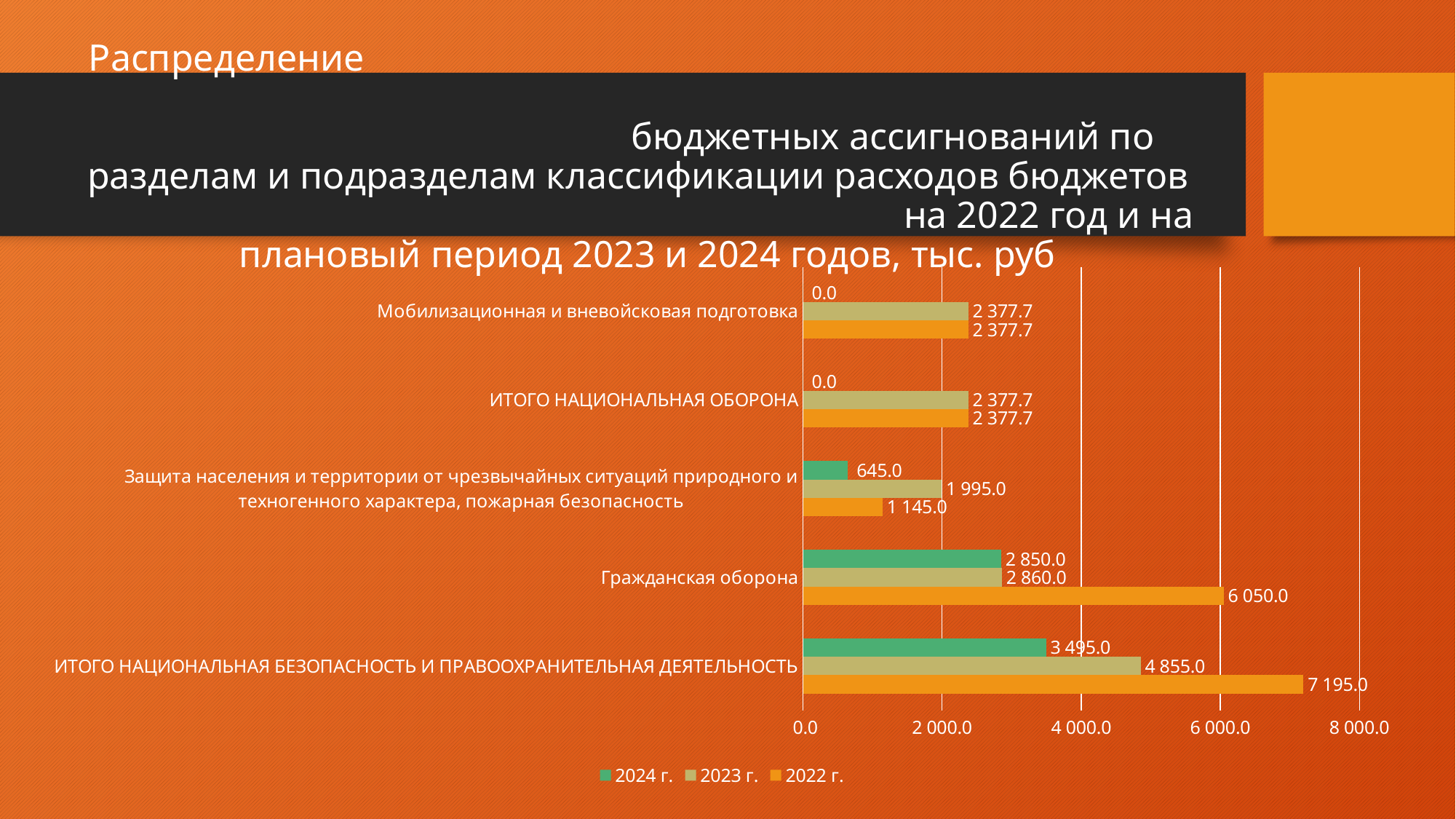
What is the value for 2024 г. for Защита населения и территории от чрезвычайных ситуаций природного и техногенного характера, пожарная безопасность? 645.0 What is the value for 2023 г. for Гражданская оборона? 2 860.0 Which category has the lowest value for 2023 г.? Защита населения и территории от чрезвычайных ситуаций природного и техногенного характера, пожарная безопасность How many series does the legend list? 3 How many categories are shown on the chart? 5 What is the difference between the 2022 г. and 2024 г. values for Гражданская оборона? 3 200.0 What is the value for 2024 г. for Мобилизационная и вневойсковая подготовка? 0.0 For Гражданская оборона, which is larger: the 2022 г. value or the 2023 г. value? 2022 г. Which category has the highest value for 2022 г.? ИТОГО НАЦИОНАЛЬНАЯ БЕЗОПАСНОСТЬ И ПРАВООХРАНИТЕЛЬНАЯ ДЕЯТЕЛЬНОСТЬ What is the value for 2022 г. for ИТОГО НАЦИОНАЛЬНАЯ БЕЗОПАСНОСТЬ И ПРАВООХРАНИТЕЛЬНАЯ ДЕЯТЕЛЬНОСТЬ? 7 195.0 What kind of chart is shown on the slide? bar chart Is the 2023 г. value for ИТОГО НАЦИОНАЛЬНАЯ БЕЗОПАСНОСТЬ И ПРАВООХРАНИТЕЛЬНАЯ ДЕЯТЕЛЬНОСТЬ greater or less than 4 000.0? greater